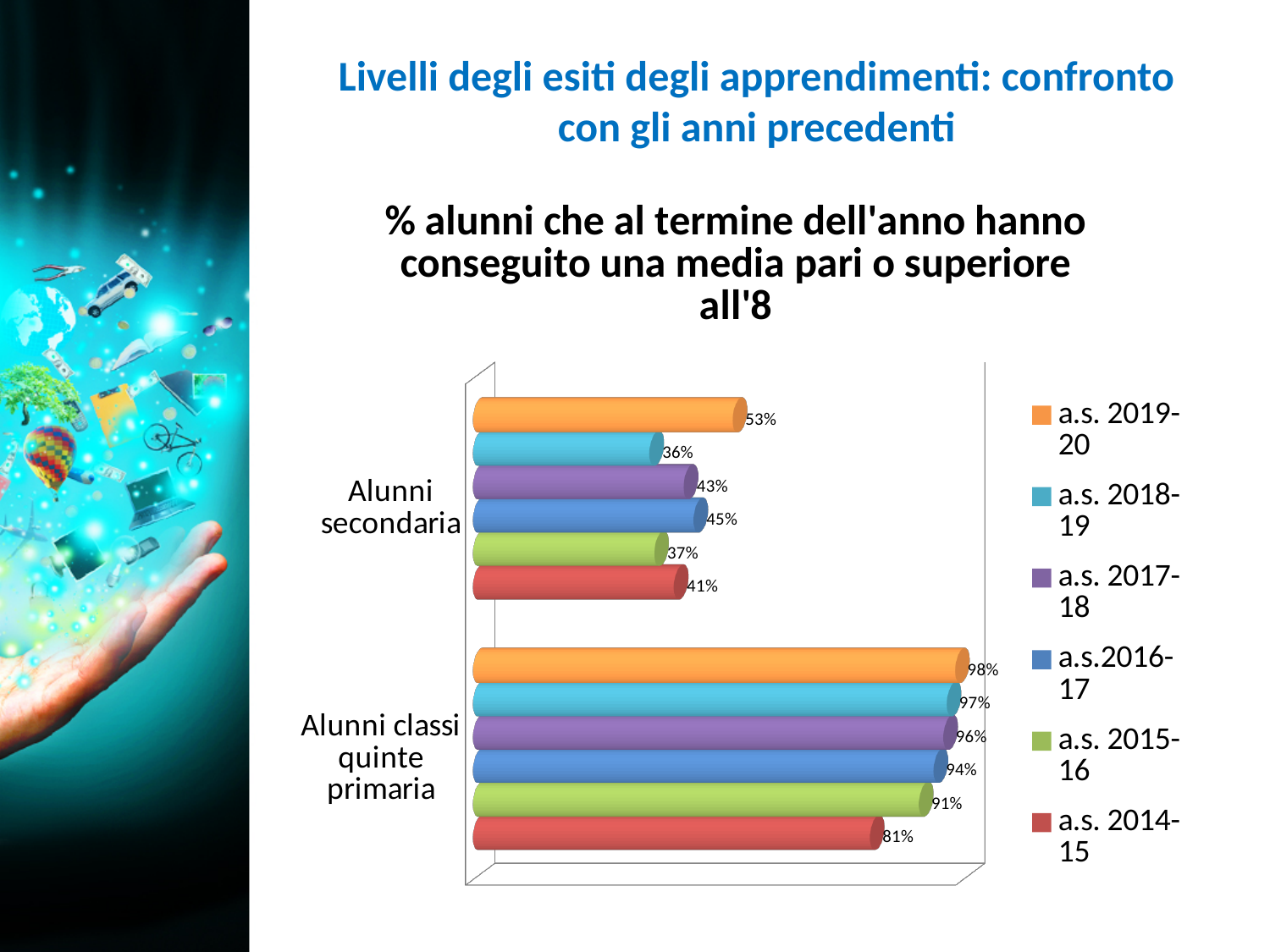
What is the title of the chart? % alunni che al termine dell'anno hanno conseguito una media pari o superiore all'8 What kind of chart is shown on the slide? Bar chart What is the value for Alunni classi quinte primaria in a.s. 2014-15? 81% Which is larger for Alunni secondaria: the a.s. 2016-17 value or the a.s. 2015-16 value? a.s. 2016-17 What is the value for Alunni classi quinte primaria in a.s. 2017-18? 96% What is the difference between the a.s. 2019-20 and a.s. 2018-19 values for Alunni secondaria? 17% What is the value for Alunni secondaria in a.s. 2018-19? 36% How many series does the legend list? 6 What is the value for Alunni secondaria in a.s. 2019-20? 53% Which school year has the highest value for Alunni secondaria? a.s. 2019-20 Which school year has the lowest value for Alunni classi quinte primaria? a.s. 2014-15 How many categories are shown on the chart? 2